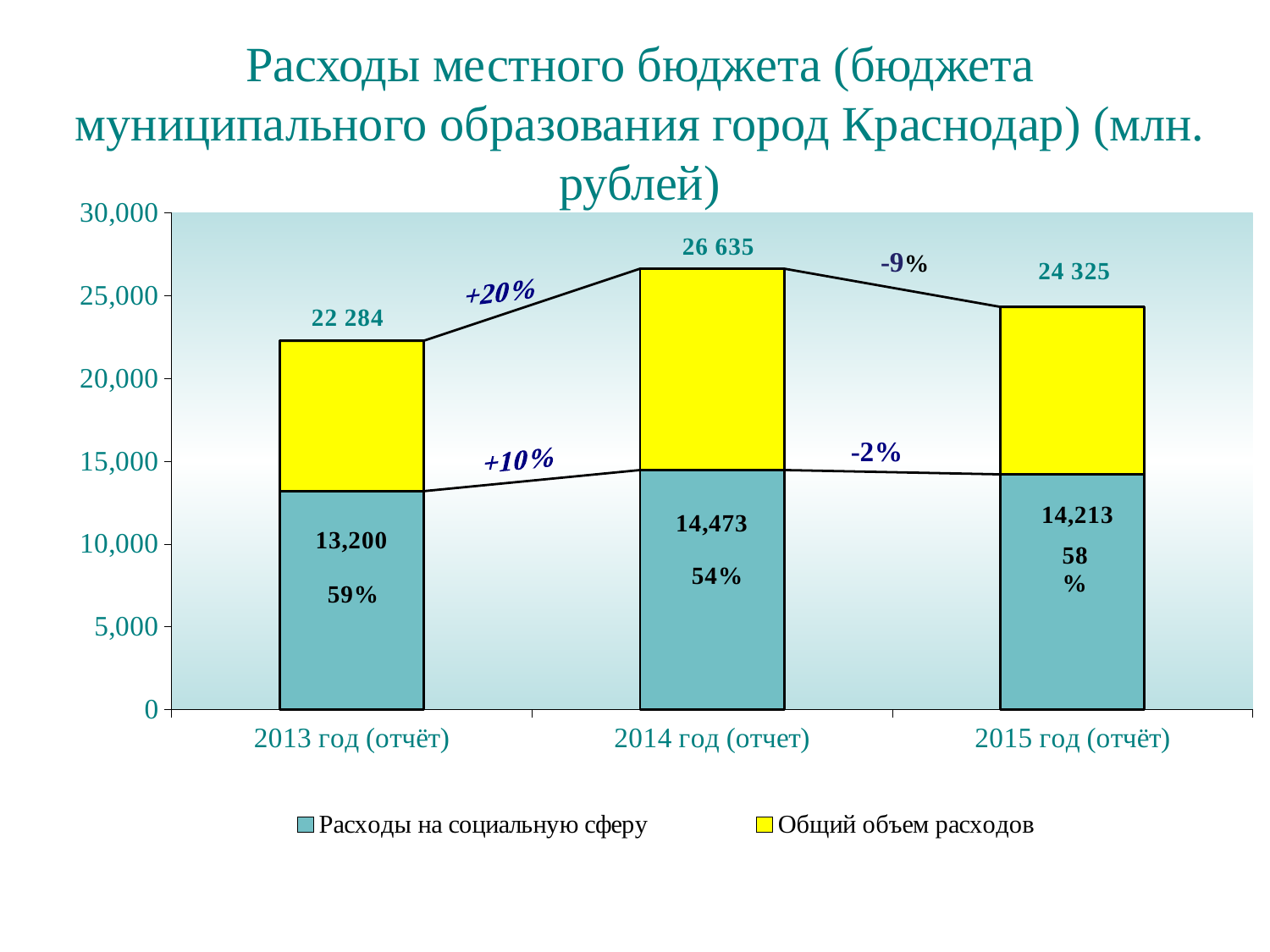
What percentage share is printed inside the 'Расходы на социальную сферу' segment for 2013 год (отчёт)? 59% Which year has the highest total labelled above its bar? 2014 год (отчет) How many series does the legend list? 2 Which year has the lowest value for 'Расходы на социальную сферу'? 2013 год (отчёт) What is the difference between the 'Расходы на социальную сферу' values for 2014 год (отчет) and 2013 год (отчёт)? 1,273 What total value is labelled above the bar for 2015 год (отчёт)? 24 325 What total value is labelled above the bar for 2014 год (отчет)? 26 635 Is the total labelled for 2013 год (отчёт) greater or less than 25,000? less What kind of chart is shown on the slide? stacked bar chart What is the value of 'Расходы на социальную сферу' for 2015 год (отчёт)? 14,213 What is the value of 'Расходы на социальную сферу' for 2013 год (отчёт)? 13,200 What is the value of 'Расходы на социальную сферу' for 2014 год (отчет)? 14,473